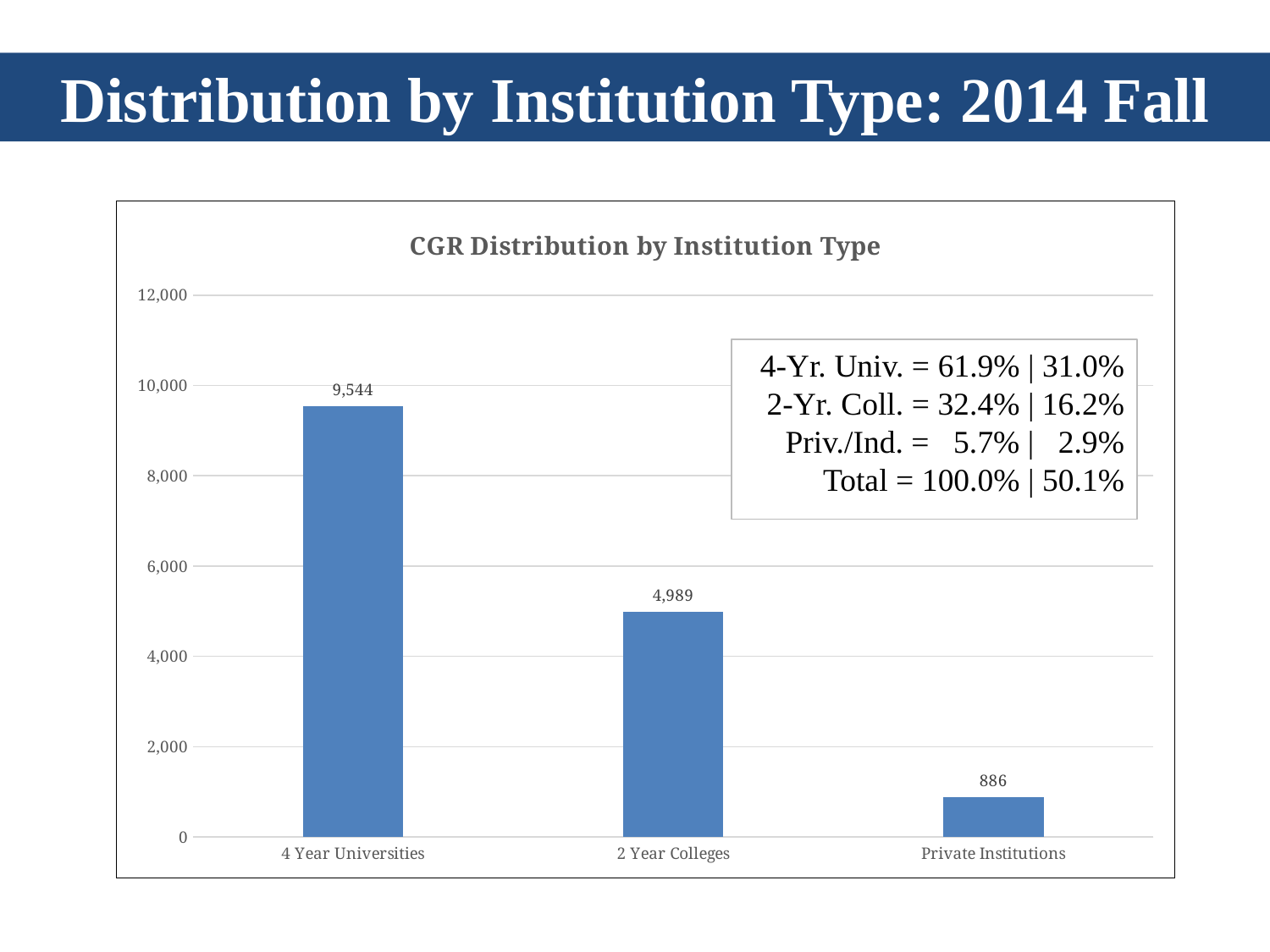
Which institution type has the highest value? 4 Year Universities What is the difference between the values for 2 Year Colleges and Private Institutions? 4,103 What is the difference between the values for 4 Year Universities and 2 Year Colleges? 4,555 Is the value for 4 Year Universities greater or less than 8,000? greater What is the value for 4 Year Universities? 9,544 Which is larger, the value for 2 Year Colleges or the value for Private Institutions? 2 Year Colleges What is the value for Private Institutions? 886 Which institution type has the lowest value? Private Institutions How many institution types are shown on the chart? 3 What kind of chart is shown on the slide? bar chart What is the value for 2 Year Colleges? 4,989 What is the title of the chart? CGR Distribution by Institution Type